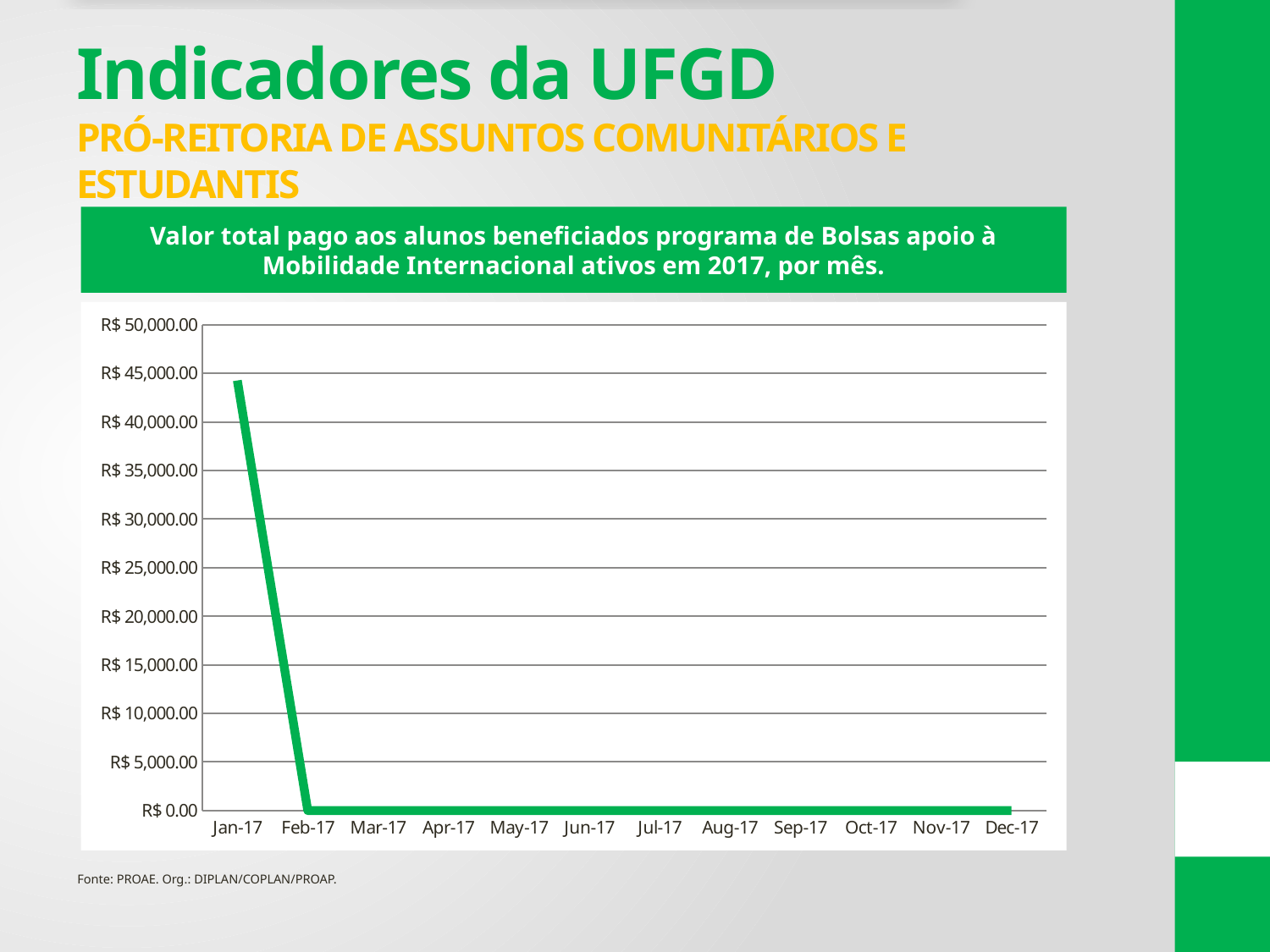
Do the values rise or fall from Jan-17 to Feb-17? fall Is the value for Jan-17 greater or less than R$ 40,000.00? greater What is the highest value shown on the y axis of the chart? R$ 50,000.00 What kind of chart is shown on the slide? line chart What is the title of the chart? Valor total pago aos alunos beneficiados programa de Bolsas apoio à Mobilidade Internacional ativos em 2017, por mês. Is the value for Jan-17 greater or less than R$ 45,000.00? less What is the value for Feb-17 in the chart? R$ 0.00 What is the value for Dec-17 in the chart? R$ 0.00 How many months are plotted along the x axis of the chart? 12 Which month has the highest value in the chart? Jan-17 Which is larger, the value for Jan-17 or the value for Mar-17? Jan-17 What is the difference between the values for Jun-17 and Nov-17? R$ 0.00